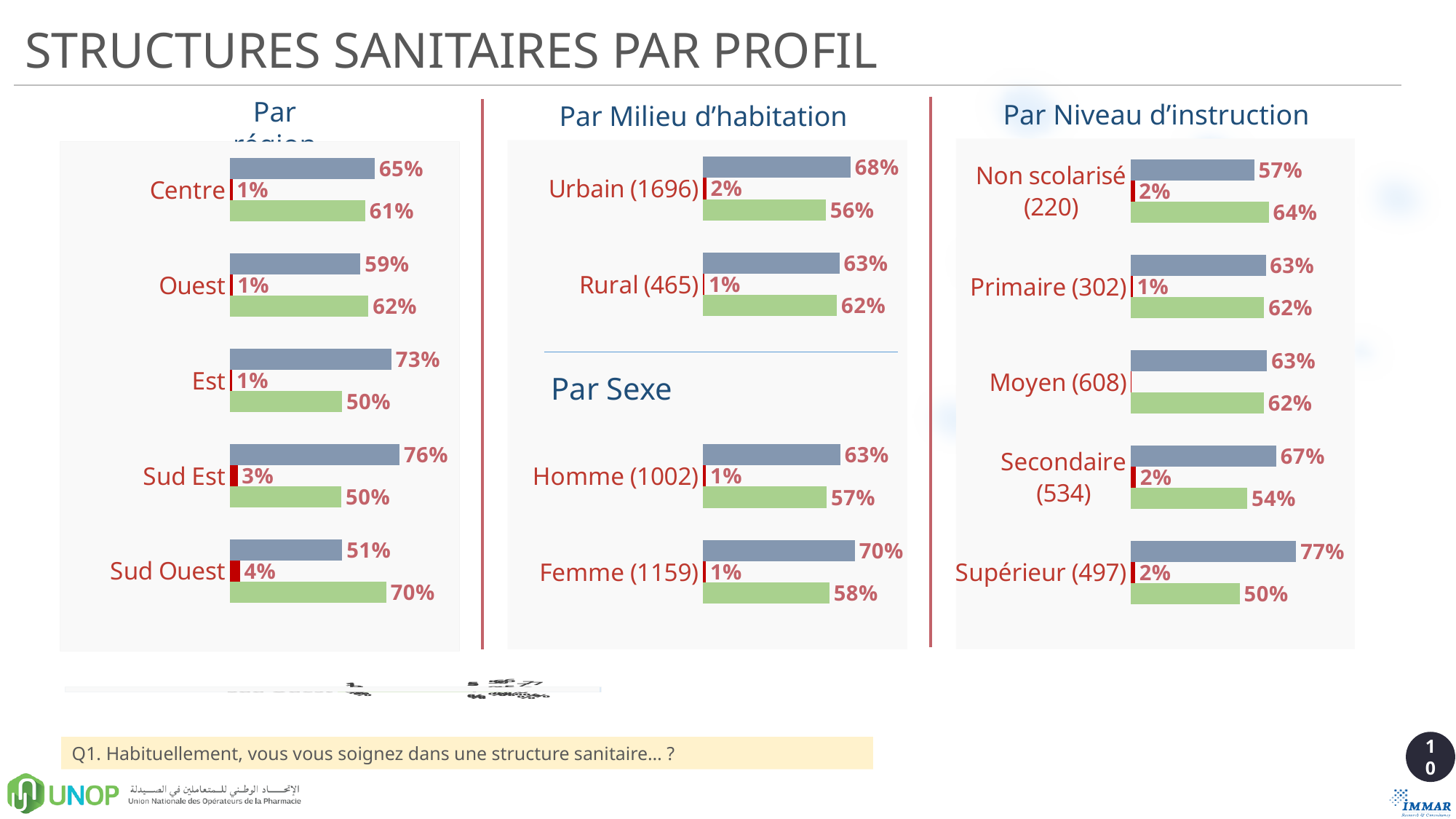
In the 'Par Niveau d'instruction' chart, which category has the lowest green bar value? Supérieur (497) In the 'Par région' chart, what is the value of the blue bar for Est? 73% In the 'Par Milieu d'habitation' chart, what is the difference between the green bar values for Rural (465) and Urbain (1696)? 6 percentage points In the 'Par Sexe' chart, which has the larger blue bar value, Homme (1002) or Femme (1159)? Femme (1159) In the 'Par Milieu d'habitation' chart, what is the value of the blue bar for Urbain (1696)? 68% In the 'Par région' chart, which region has the highest blue bar value? Sud Est What kind of chart is used in the 'Par Niveau d'instruction' section? Bar chart In the 'Par région' chart, what is the value of the red bar for Sud Ouest? 4% In the 'Par Sexe' chart, what is the value of the blue bar for Femme (1159)? 70% In the 'Par région' chart, what is the value of the green bar for Sud Ouest? 70% In the 'Par Niveau d'instruction' chart, what is the value of the blue bar for Supérieur (497)? 77% In the 'Par région' chart, how many regions are shown? 5